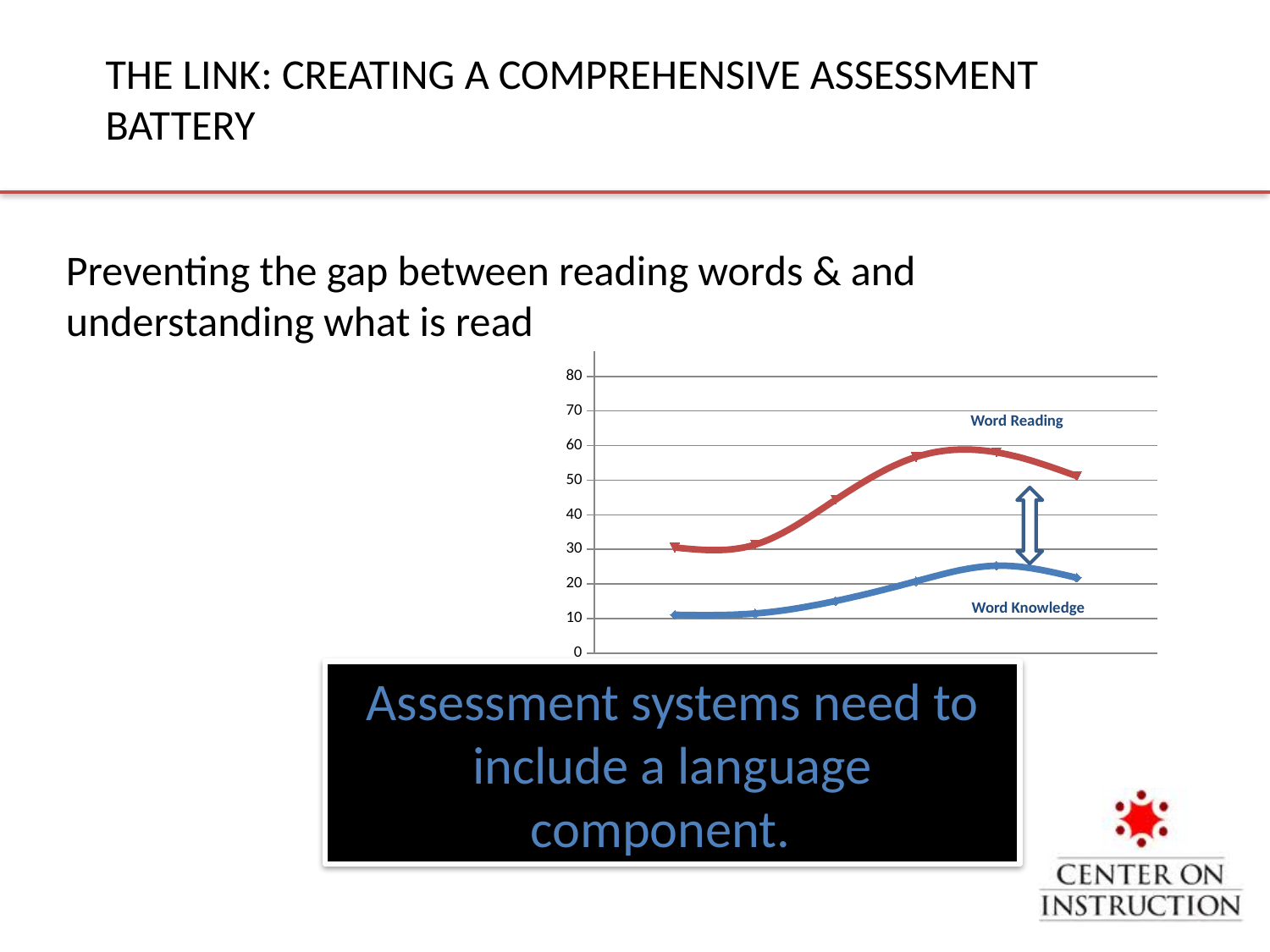
What kind of chart is shown on the slide? line chart Is the highest value on the Word Knowledge line greater or less than 30? less What are the names of the two series labelled on the chart? Word Reading and Word Knowledge How many data points are plotted on the Word Reading line? 6 How many lines (series) are plotted on the chart? 2 What colour is the Word Reading line? red Which series has higher values across the chart, Word Reading or Word Knowledge? Word Reading Is the first (leftmost) value on the Word Knowledge line greater or less than 20? less Is the highest value on the Word Reading line greater or less than 50? greater Does the Word Reading line rise or fall between its first point and its peak? rise What is the highest value shown on the y axis? 80